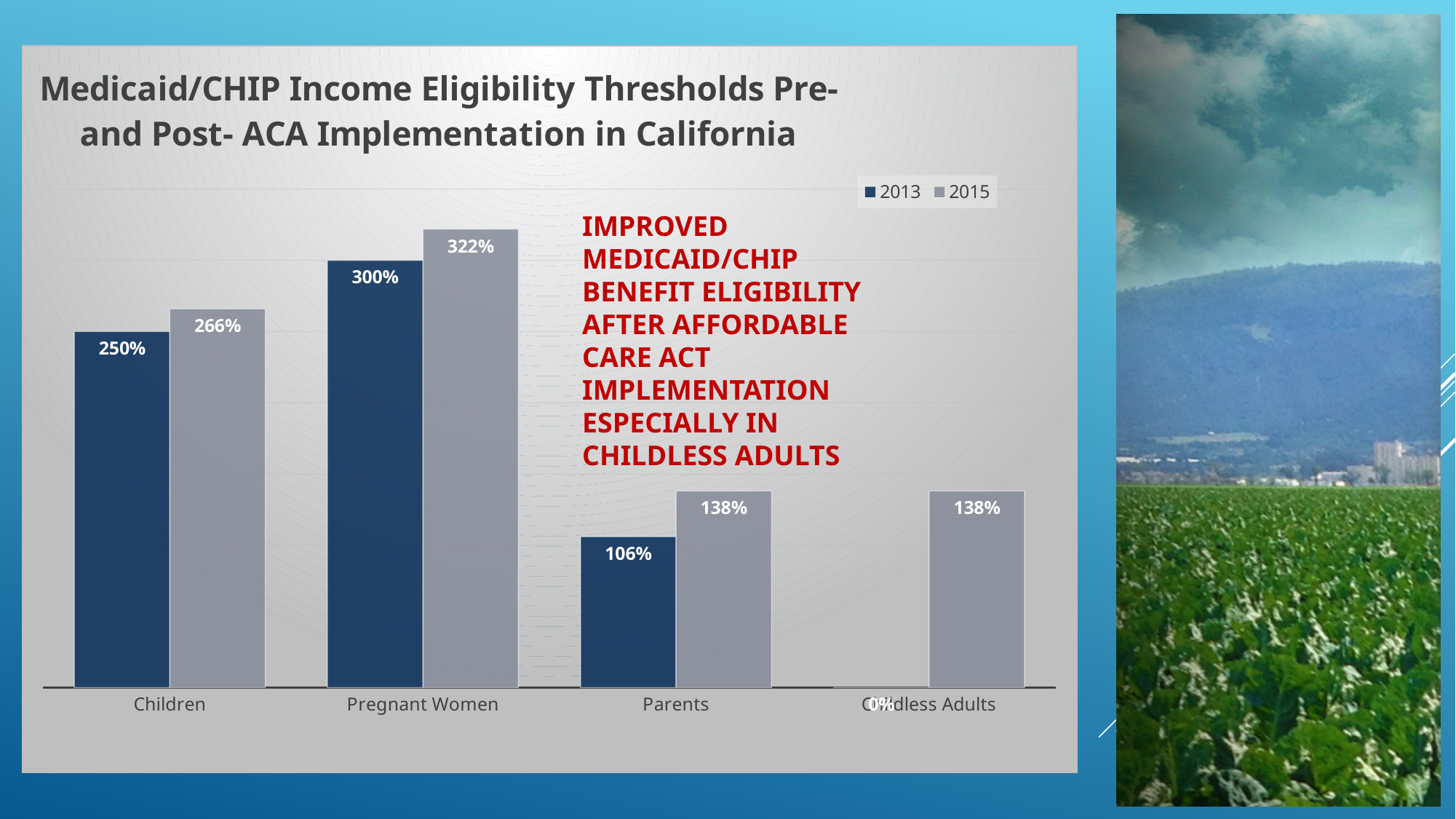
What is the 2013 value for Children? 250% What is the difference between the 2015 and 2013 values for Parents? 32% How many series does the legend list? 2 Which category has the highest 2015 value? Pregnant Women What is the 2015 value for Childless Adults? 138% What is the 2013 value for Parents? 106% What is the difference between the 2015 and 2013 values for Children? 16% How many categories are shown on the x axis? 4 Which category has the lowest 2013 value? Childless Adults What is the 2015 value for Pregnant Women? 322% Which is larger, the 2013 value for Pregnant Women or the 2015 value for Children? 2013 value for Pregnant Women What kind of chart is shown on the slide? Bar chart